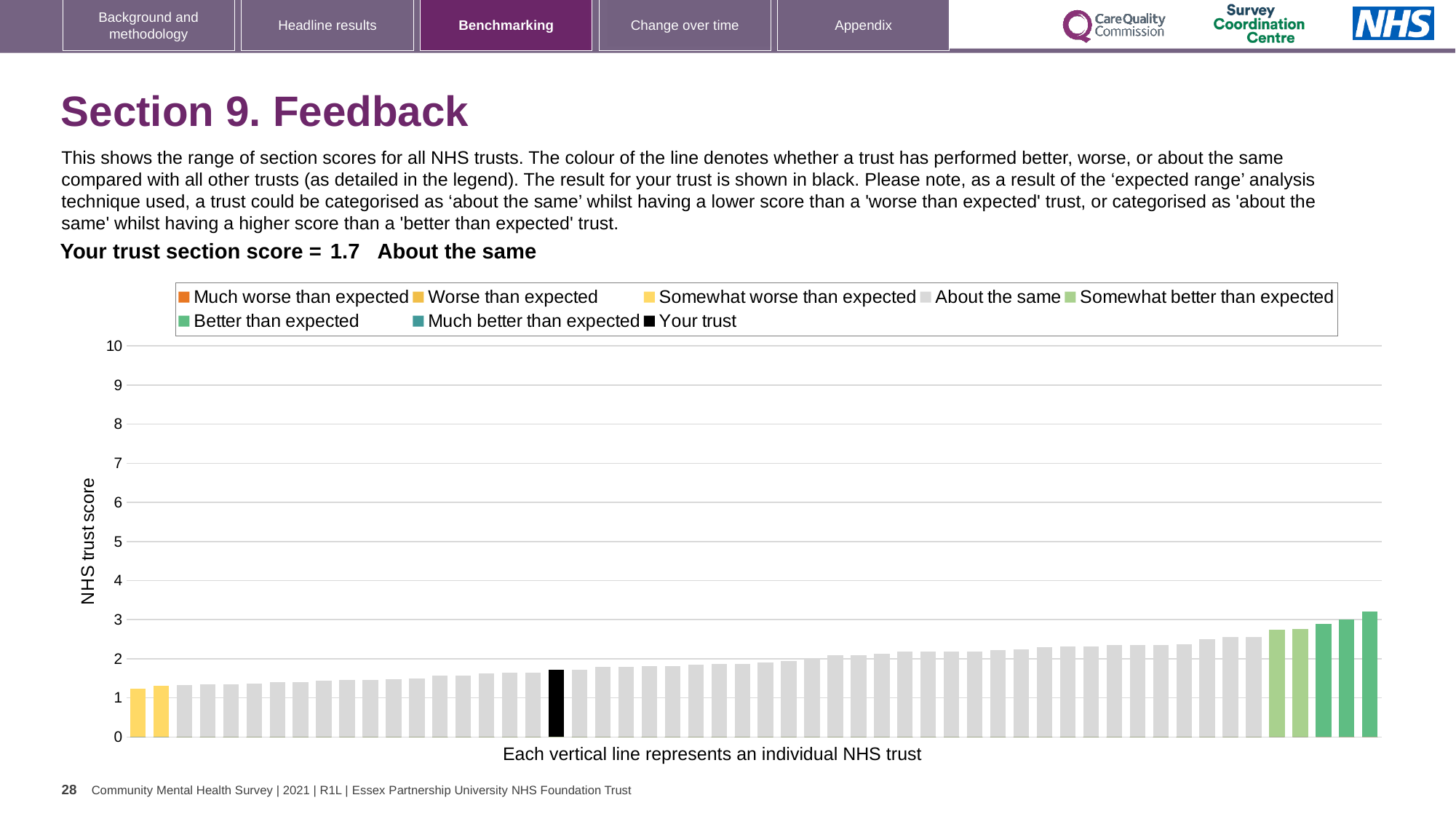
Is the value for your trust greater or less than 5? less Is the value for your trust greater or less than 1? greater Is your trust's bar higher or lower than the rightmost bar? lower What kind of chart is shown on the slide? bar chart Which category is your trust's section score placed in? About the same Is the value of the leftmost bar greater or less than 2? less Is your trust's bar higher or lower than the leftmost bar? higher What is the label on the vertical axis of the chart? NHS trust score What is the section score for your trust? 1.7 How many entries does the chart legend list? 8 Do the bar values rise or fall from left to right along the x axis? rise